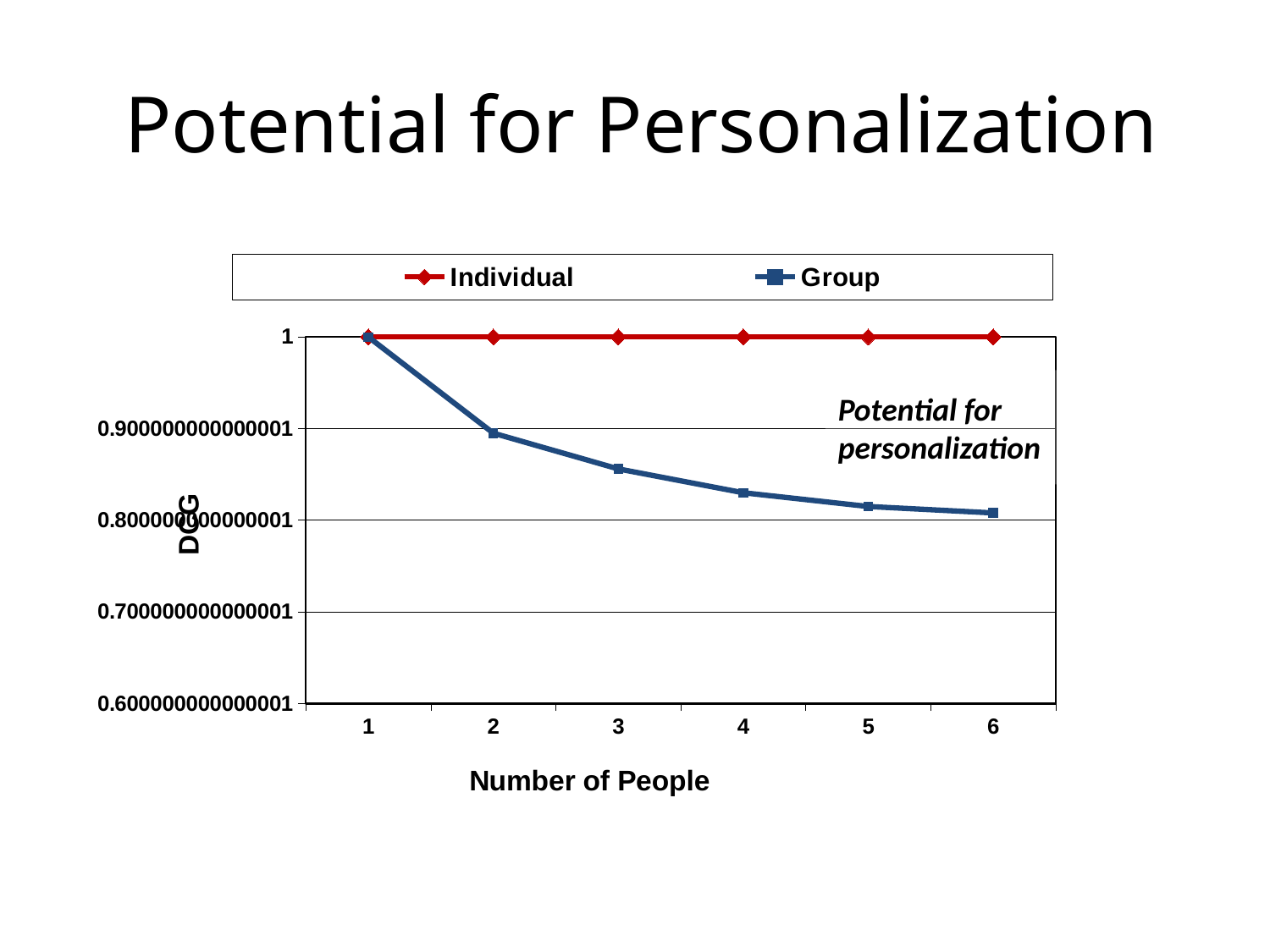
What is the title of the y axis? DCG How many points along the x axis (Number of People) are plotted for each series? 6 Is the Group value at 6 people greater or less than 0.800000000000001? greater What is the DCG value for the Group series at 1 person? 1 At 4 people, which series has the higher DCG, Individual or Group? Individual Does the Group series rise or fall as the number of people increases? fall What kind of chart is shown on the slide? line chart How many series does the legend list? 2 Is the Group value at 3 people greater or less than 0.900000000000001? less At which number of people is the Group series lowest? 6 What is the DCG value for the Individual series at 3 people? 1 What is the title of the x axis? Number of People